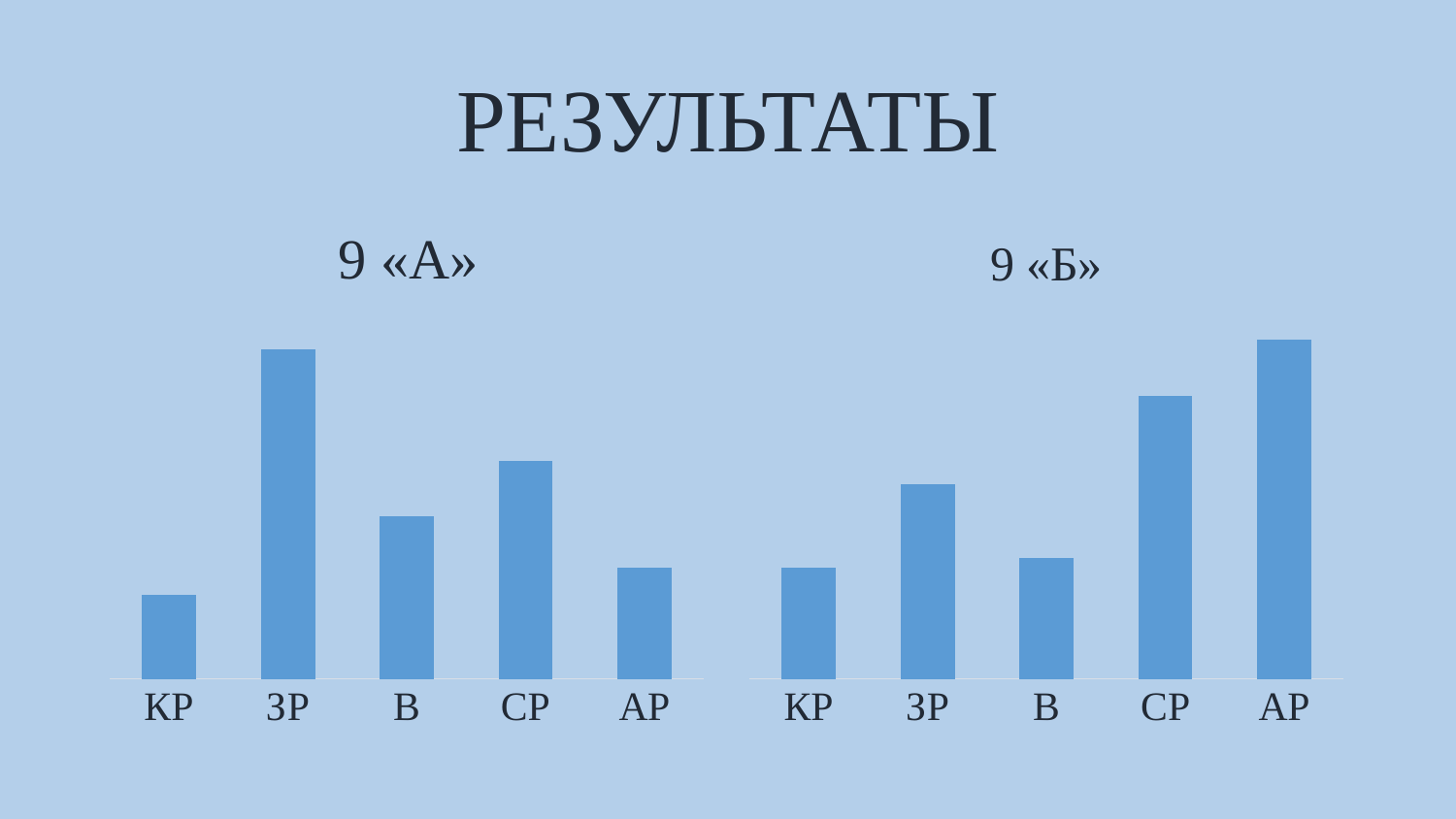
In the 9 «А» chart, which is larger, the value for ЗР or the value for СР? ЗР In the 9 «А» chart, which is larger, the value for СР or the value for В? СР In the 9 «Б» chart, which is larger, the value for СР or the value for ЗР? СР In the 9 «А» chart, which category has the highest bar? ЗР In the 9 «Б» chart, which category has the highest bar? АР What kind of chart is the 9 «Б» chart? Bar chart How many categories are shown in the 9 «А» chart? 5 What is the title of the chart on the right side of the slide? 9 «Б» In the 9 «А» chart, which category has the lowest bar? КР What is the title of the slide containing the two charts? РЕЗУЛЬТАТЫ How many categories are shown in the 9 «Б» chart? 5